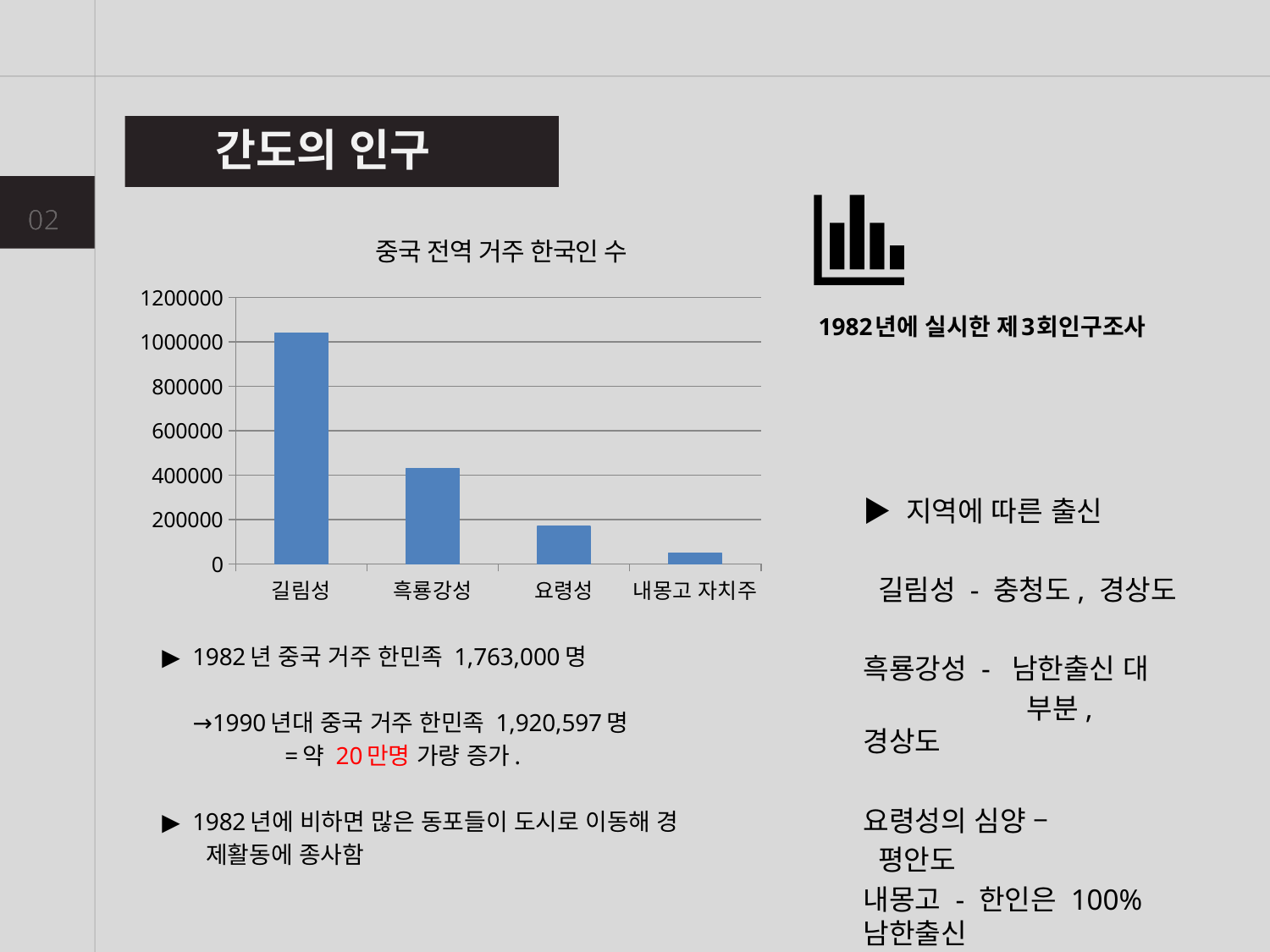
Is the value for 흑룡강성 greater or less than 600000? less Which has a larger value, 요령성 or 내몽고 자치주? 요령성 Which category has the highest value in the chart? 길림성 What kind of chart is shown on the slide? bar chart Which has a larger value, 흑룡강성 or 요령성? 흑룡강성 What is the title of the chart? 중국 전역 거주 한국인 수 Is the value for 요령성 greater or less than 200000? less Which category has the lowest value in the chart? 내몽고 자치주 Is the value for 길림성 greater or less than 800000? greater Do the values rise or fall from left to right along the x axis? fall What is the highest value shown on the y axis of the chart? 1200000 How many categories are shown on the x axis of the chart? 4